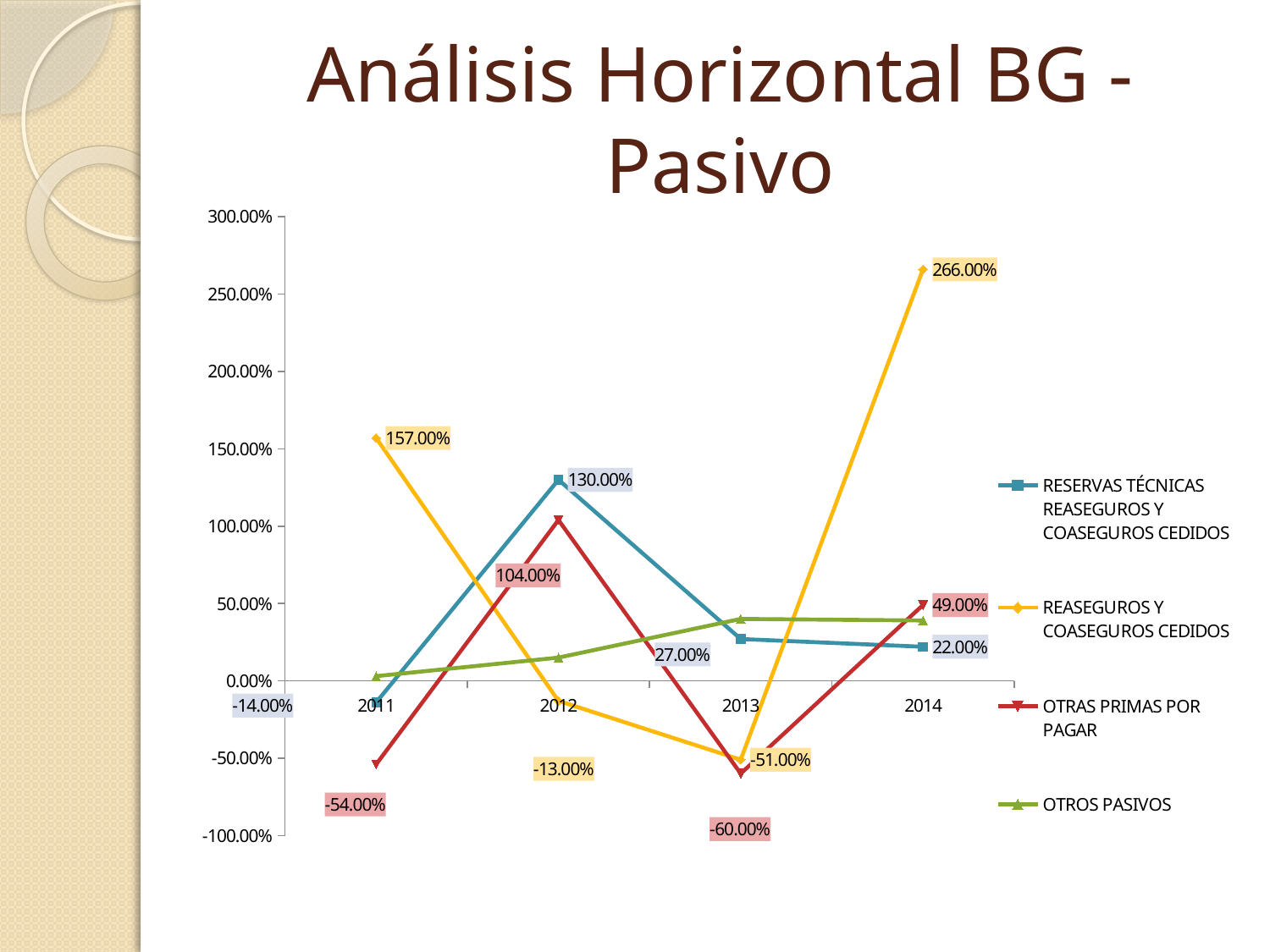
In which year does REASEGUROS Y COASEGUROS CEDIDOS reach its highest value? 2014 What is the title of the chart slide? Análisis Horizontal BG - Pasivo What is the value for OTRAS PRIMAS POR PAGAR in 2013? -60.00% What is the value for REASEGUROS Y COASEGUROS CEDIDOS in 2014? 266.00% How many series does the legend list? 4 What is the difference between the 2014 and 2011 values for REASEGUROS Y COASEGUROS CEDIDOS? 109.00% What is the value for RESERVAS TÉCNICAS REASEGUROS Y COASEGUROS CEDIDOS in 2012? 130.00% What kind of chart is shown on the slide? line chart In which year does OTRAS PRIMAS POR PAGAR have its lowest value? 2013 How many years are shown on the x axis? 4 In 2012, which is larger: RESERVAS TÉCNICAS REASEGUROS Y COASEGUROS CEDIDOS or OTRAS PRIMAS POR PAGAR? RESERVAS TÉCNICAS REASEGUROS Y COASEGUROS CEDIDOS Is the value for OTROS PASIVOS in 2013 greater or less than 50.00%? less